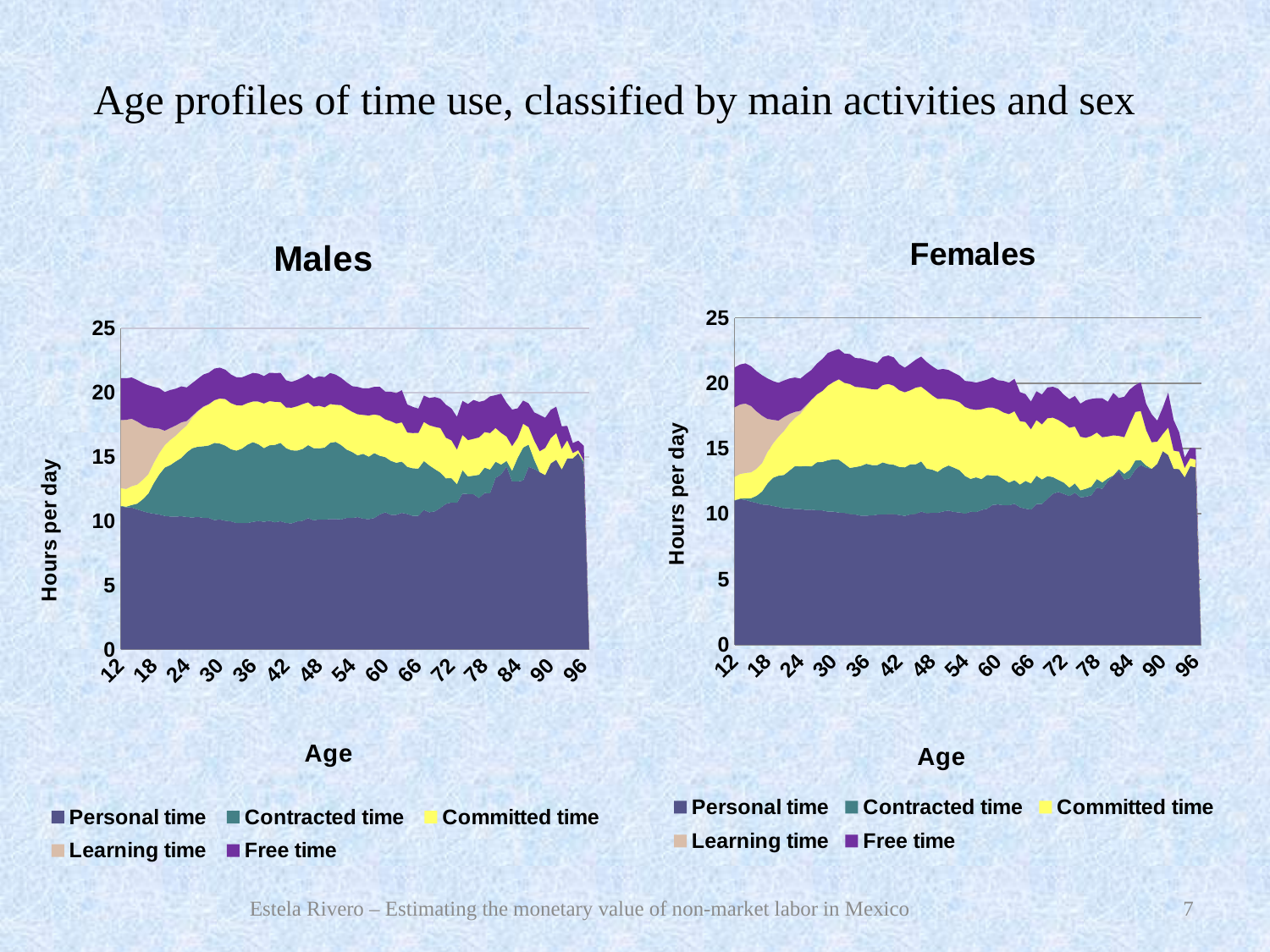
Which series is shown in yellow in the Females chart? Committed time In the Females chart, does the Personal time area rise or fall from age 12 to age 96? rise What kind of chart is the Males chart? Stacked area chart In the Females chart, is the Personal time value at age 36 greater or less than 15? less In the Males chart, does the total stacked height rise or fall from age 12 to age 96? fall How many series does the legend of the Females chart list? 5 In the Females chart, is the total stacked value at age 96 greater or less than 20? less What is the highest value shown on the y axis of the Females chart? 25 How many age labels are shown on the x axis of the Males chart? 15 In the Males chart, is the Personal time value at age 12 greater or less than 10? greater What is the y-axis label on the Males chart? Hours per day